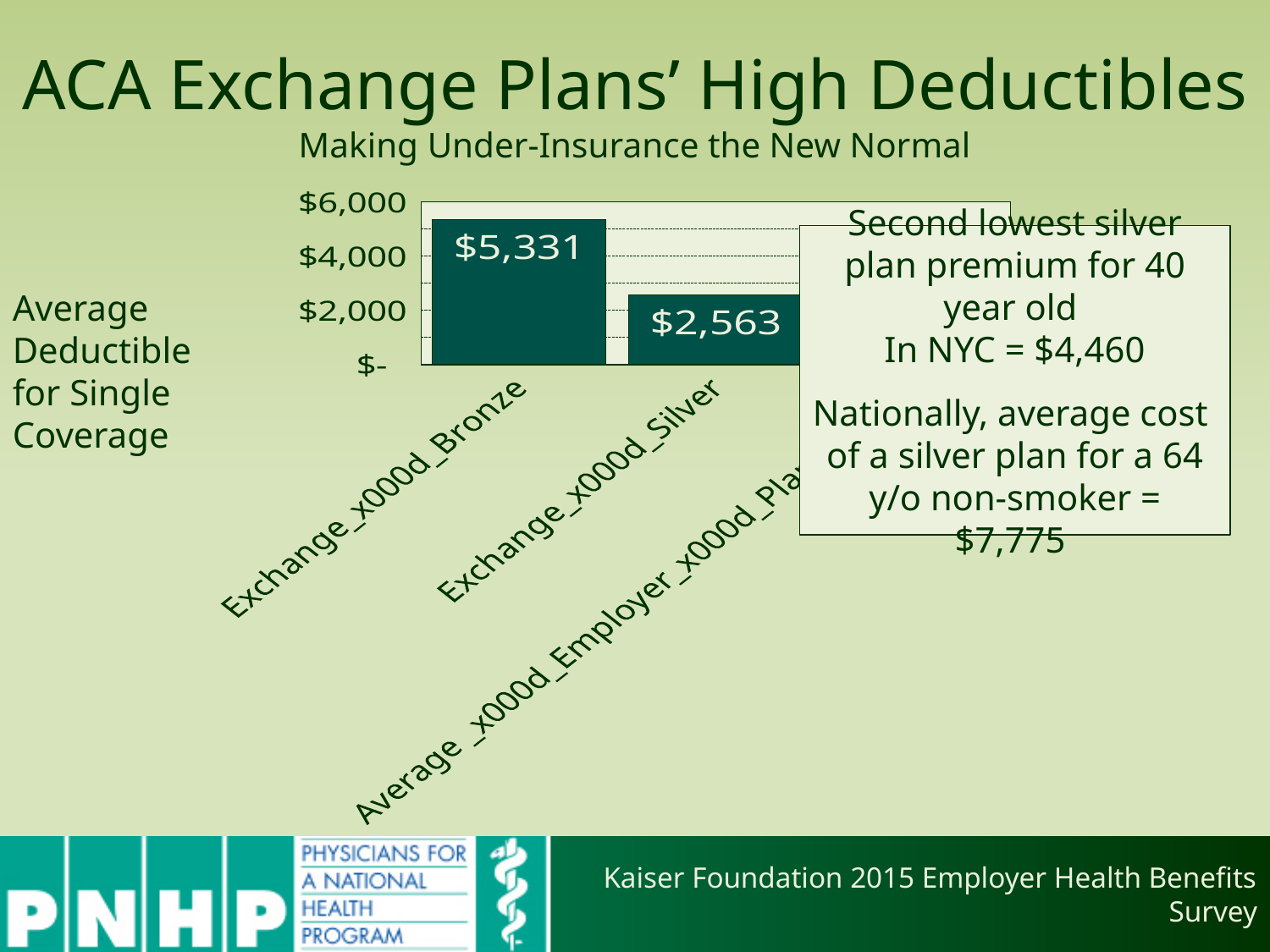
What is the highest value shown on the chart's y axis? $6,000 Which has the larger average deductible, Exchange Bronze or Exchange Silver? Exchange Bronze What kind of chart is shown on the slide? Bar chart Is the value for Exchange Silver greater or less than $2,000? greater What does the text to the left of the chart say the chart measures? Average Deductible for Single Coverage What is the average deductible for single coverage shown for the Exchange Bronze plan? $5,331 Is the value for Exchange Bronze greater or less than $4,000? greater What is the difference between the Exchange Bronze deductible and the Exchange Silver deductible? $2,768 Is the value for Exchange Silver greater or less than $4,000? less What is the average deductible for single coverage shown for the Exchange Silver plan? $2,563 How many categories are labelled on the x axis of the chart? 3